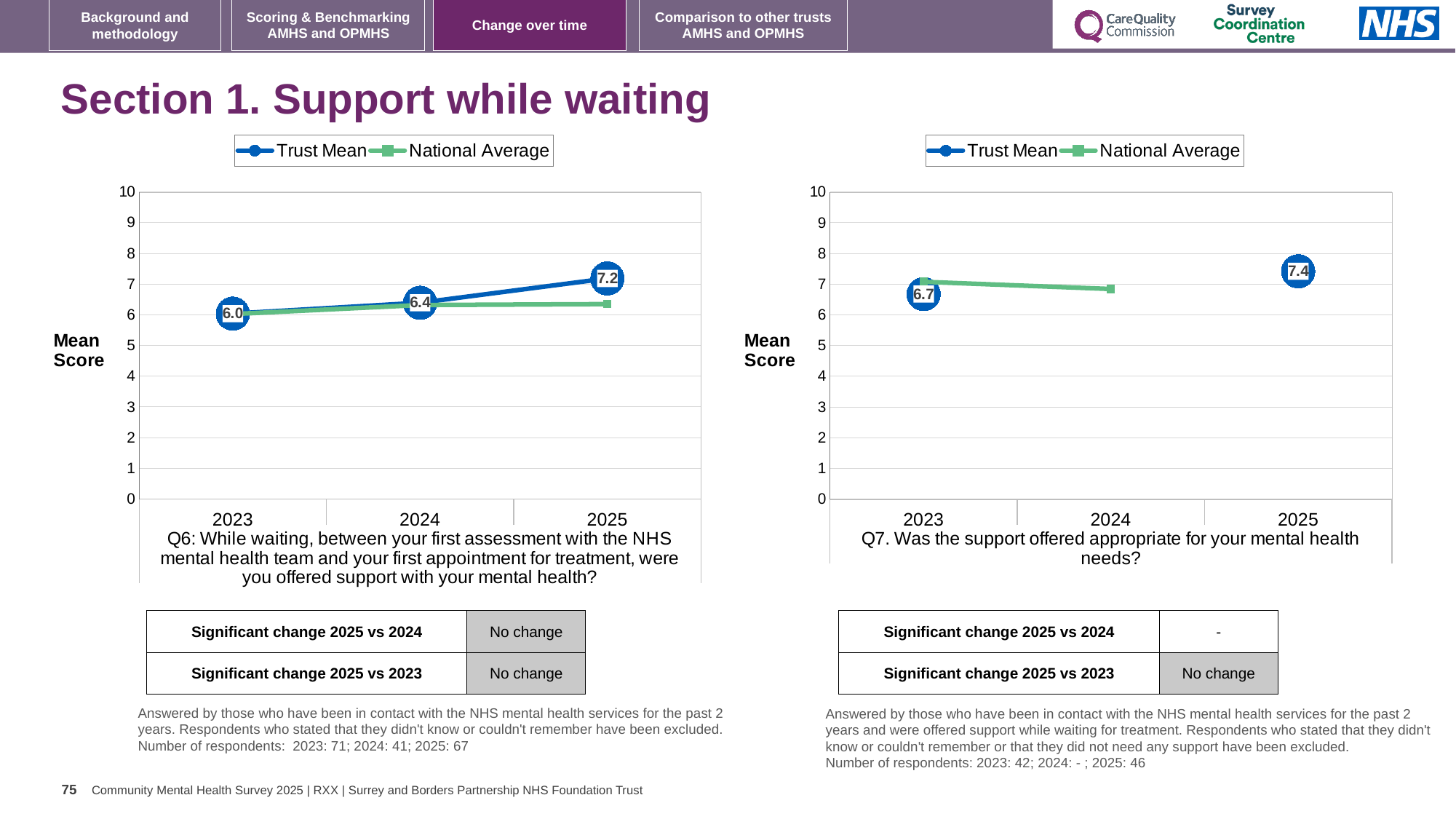
In the Q6 chart on the left, does the Trust Mean rise or fall from 2023 to 2025? rise In the Q6 chart on the left, is the National Average for 2025 greater or less than 7? less In the Q7 chart on the right, what is the Trust Mean score for 2025? 7.4 How many series does the legend of the Q6 chart on the left list? 2 In the Q6 chart on the left, which year has the lowest Trust Mean score? 2023 In the Q6 chart on the left, what is the Trust Mean score for 2023? 6.0 In the Q7 chart on the right, what is the difference between the Trust Mean in 2025 and in 2023? 0.7 In the Q6 chart on the left, by how much did the Trust Mean increase from 2023 to 2025? 1.2 In the Q7 chart on the right, which is larger in 2025: the Trust Mean or the National Average for 2024? Trust Mean In the Q6 chart on the left, which year has the highest Trust Mean score? 2025 What type of chart is used for Q7 on the right? line chart In the Q6 chart on the left, what is the Trust Mean score for 2025? 7.2